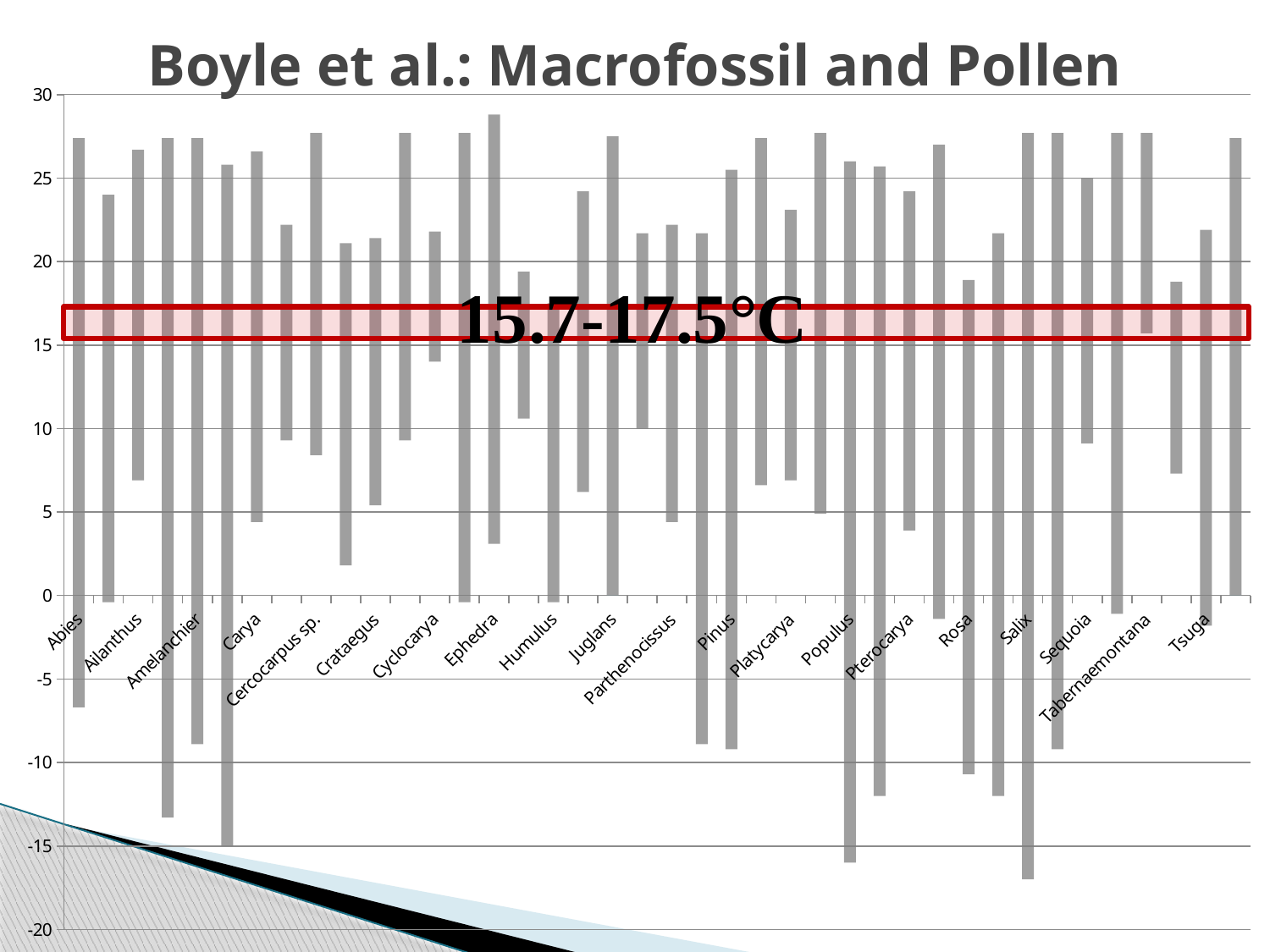
Is the upper end of the bar for Tsuga greater or less than 25? less What temperature range is written in the highlighted red band across the chart? 15.7-17.5°C What is the highest value shown on the y axis of the chart? 30 Which is the last taxon labeled on the x axis of the chart? Tsuga What is the lowest value shown on the y axis of the chart? -20 How many taxa are labeled along the x axis of the chart? 20 Is the lower end of the bar for Abies greater or less than 0? less Is the upper end of the bar for Abies greater or less than 25? greater What kind of chart is shown on the slide? bar chart What is the title of the chart on the slide? Boyle et al.: Macrofossil and Pollen Which is the first taxon labeled on the x axis of the chart? Abies